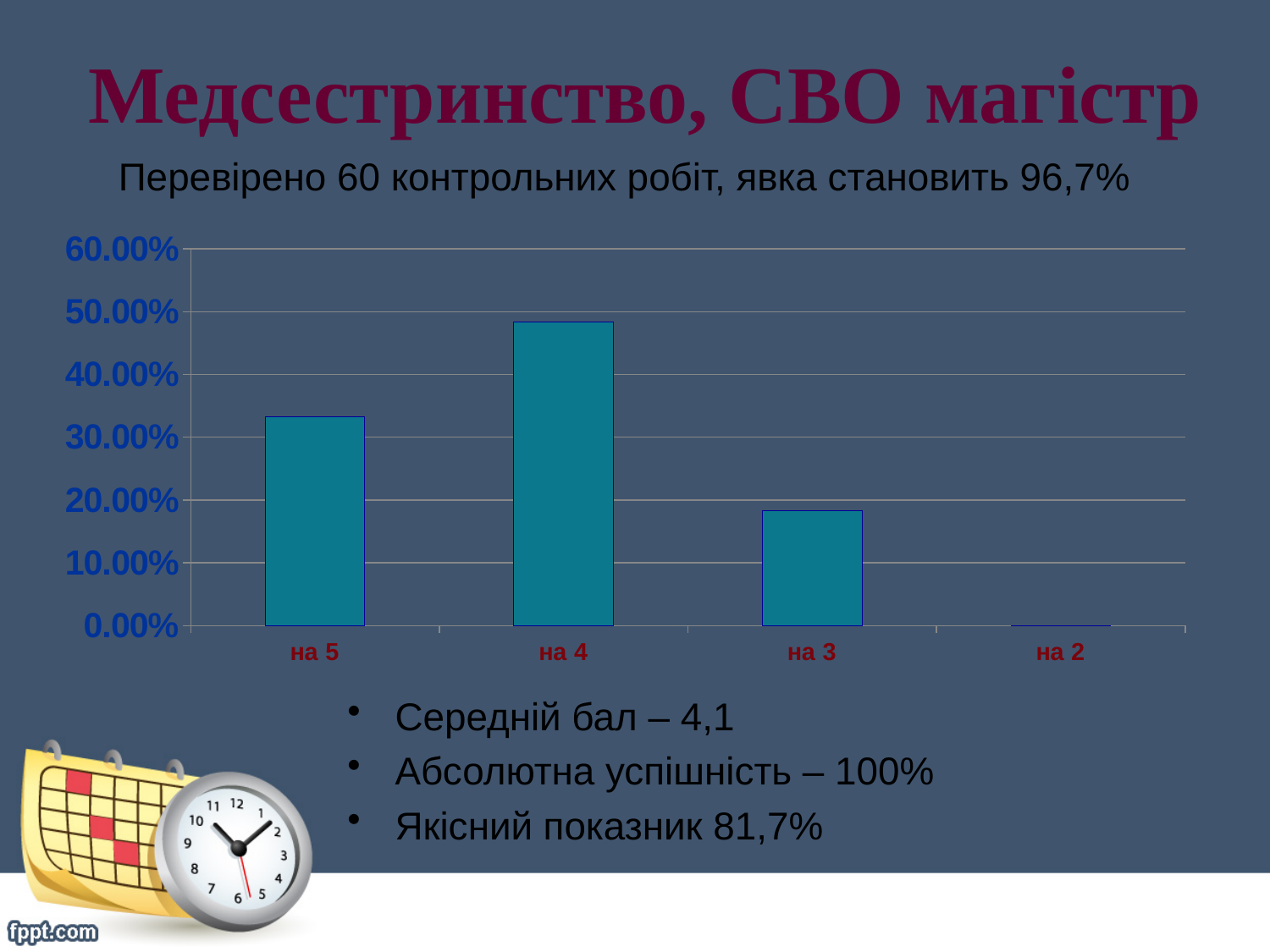
Do the values rise or fall from на 4 to на 2 along the x axis? fall Is the value for на 3 greater or less than 20.00%? less Which is larger, the value for на 4 or the value for на 5? на 4 Is the value for на 5 greater or less than 30.00%? greater Is the value for на 4 greater or less than 50.00%? less Which category has the highest bar in the chart? на 4 What is the highest tick value shown on the vertical axis of the chart? 60.00% What kind of chart is shown on the slide? bar chart How many categories are shown on the x axis of the chart? 4 Which category has the lowest bar in the chart? на 2 Which is larger, the value for на 5 or the value for на 3? на 5